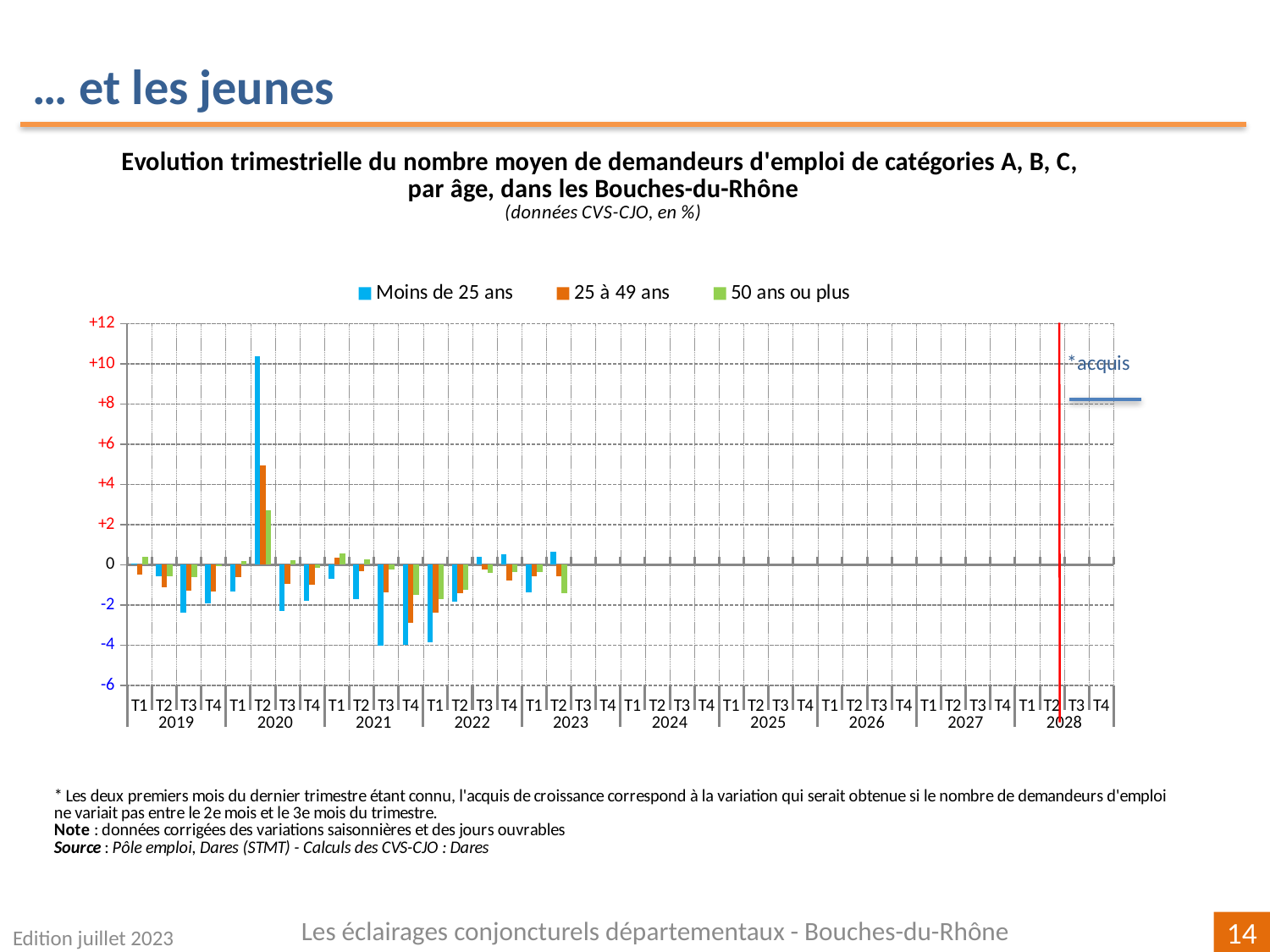
In T2 2020, which series has the larger value: 'Moins de 25 ans' or '25 à 49 ans'? Moins de 25 ans What are the three series listed in the legend? Moins de 25 ans, 25 à 49 ans, 50 ans ou plus What kind of chart is shown on the slide? bar chart How many years are labelled along the x axis? 10 In which quarter does the series 'Moins de 25 ans' reach its highest value? T2 2020 Is the value for 'Moins de 25 ans' in T2 2020 greater or less than +8? greater In T4 2021, which series has the lowest value? Moins de 25 ans Is the value for 'Moins de 25 ans' in T4 2021 greater or less than -2? less Which colour represents the series 'Moins de 25 ans'? blue How many series does the legend list? 3 Is the value for '50 ans ou plus' in T2 2020 greater or less than +2? greater